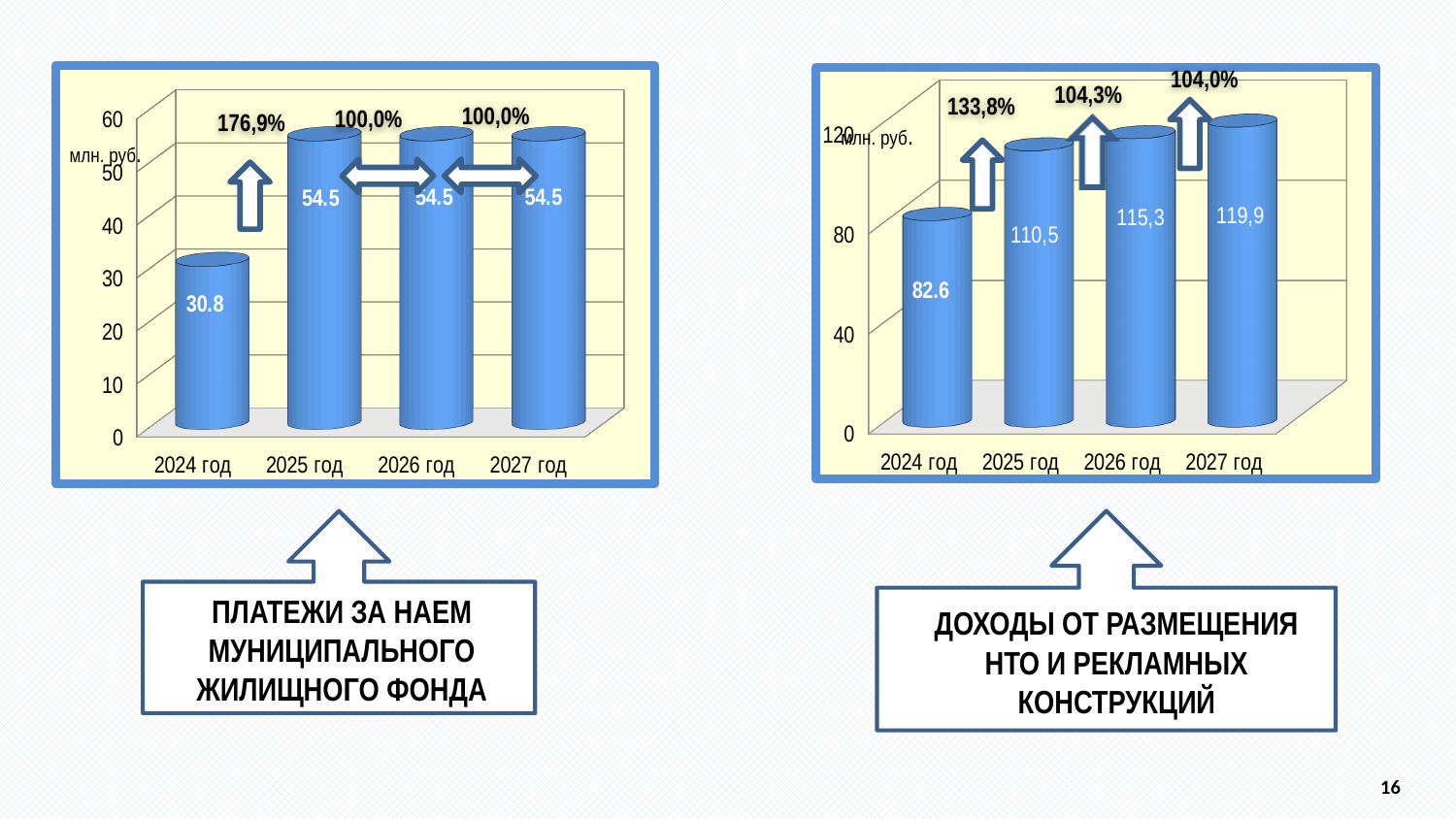
In the left chart (ПЛАТЕЖИ ЗА НАЕМ МУНИЦИПАЛЬНОГО ЖИЛИЩНОГО ФОНДА), what percentage label is shown above the 2025 год bar? 176,9% In the right chart (ДОХОДЫ ОТ РАЗМЕЩЕНИЯ НТО И РЕКЛАМНЫХ КОНСТРУКЦИЙ), do the values rise or fall from 2024 год to 2027 год? rise In the right chart (ДОХОДЫ ОТ РАЗМЕЩЕНИЯ НТО И РЕКЛАМНЫХ КОНСТРУКЦИЙ), what is the value for 2024 год? 82.6 What kind of chart is the right chart (ДОХОДЫ ОТ РАЗМЕЩЕНИЯ НТО И РЕКЛАМНЫХ КОНСТРУКЦИЙ)? bar chart In the left chart (ПЛАТЕЖИ ЗА НАЕМ МУНИЦИПАЛЬНОГО ЖИЛИЩНОГО ФОНДА), how many years are shown on the x axis? 4 In the left chart (ПЛАТЕЖИ ЗА НАЕМ МУНИЦИПАЛЬНОГО ЖИЛИЩНОГО ФОНДА), what is the difference between the values for 2025 год and 2024 год? 23.7 In the right chart (ДОХОДЫ ОТ РАЗМЕЩЕНИЯ НТО И РЕКЛАМНЫХ КОНСТРУКЦИЙ), which year has the highest value? 2027 год In the left chart (ПЛАТЕЖИ ЗА НАЕМ МУНИЦИПАЛЬНОГО ЖИЛИЩНОГО ФОНДА), which year has the lowest value? 2024 год In the right chart (ДОХОДЫ ОТ РАЗМЕЩЕНИЯ НТО И РЕКЛАМНЫХ КОНСТРУКЦИЙ), which is larger, the value for 2025 год or the value for 2024 год? 2025 год In the left chart (ПЛАТЕЖИ ЗА НАЕМ МУНИЦИПАЛЬНОГО ЖИЛИЩНОГО ФОНДА), what is the value for 2026 год? 54.5 In the left chart (ПЛАТЕЖИ ЗА НАЕМ МУНИЦИПАЛЬНОГО ЖИЛИЩНОГО ФОНДА), what is the value for 2024 год? 30.8 In the right chart (ДОХОДЫ ОТ РАЗМЕЩЕНИЯ НТО И РЕКЛАМНЫХ КОНСТРУКЦИЙ), what is the value for 2026 год? 115,3